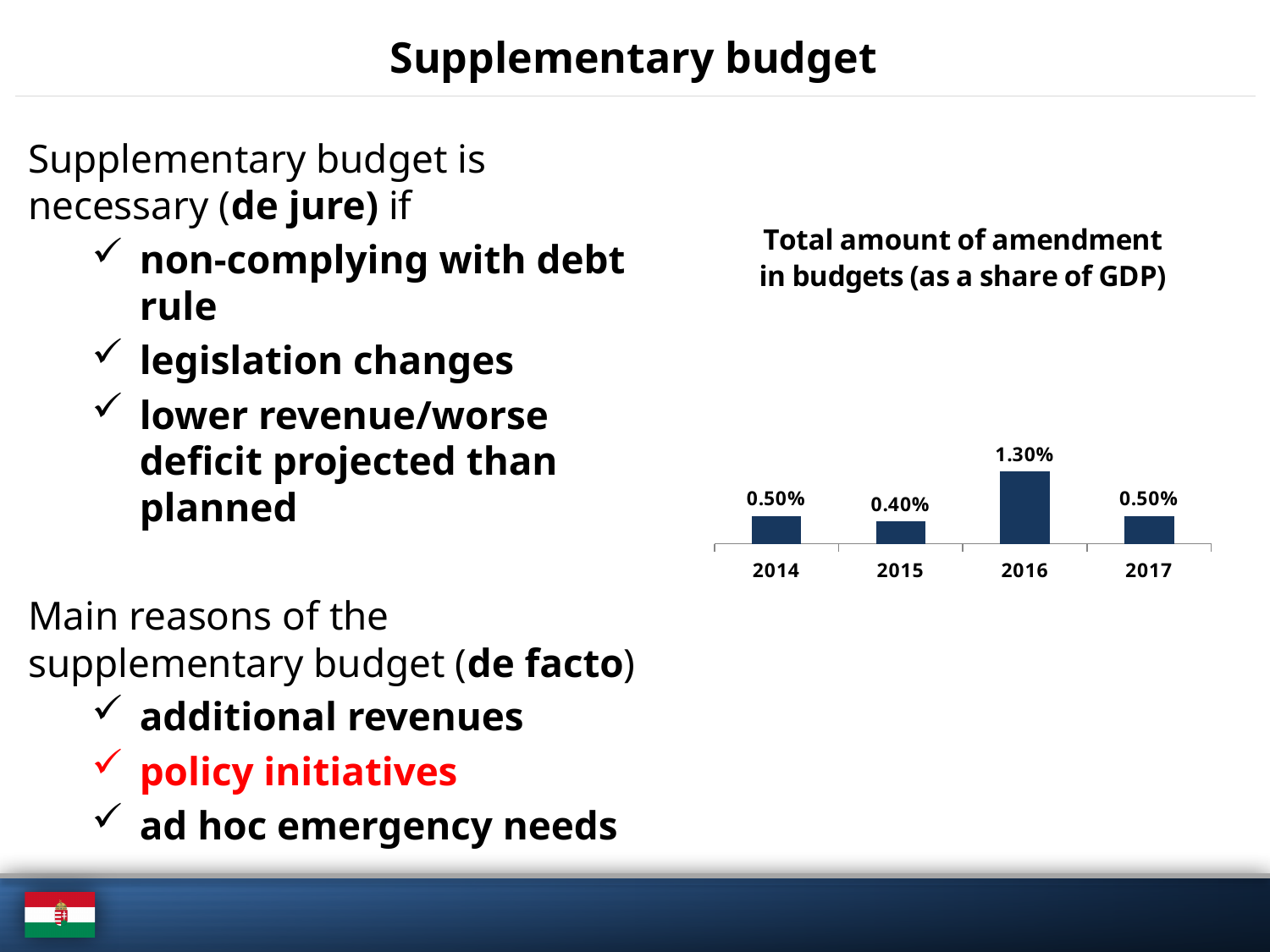
What is the difference between the values for 2014 and 2015? 0.10% What is the title of the chart? Total amount of amendment in budgets (as a share of GDP) What is the value for 2014 in the chart? 0.50% How many years are shown in the chart? 4 What kind of chart is shown on the slide? Bar chart What is the value for 2015 in the chart? 0.40% Which year has the highest total amount of amendment in budgets? 2016 What is the difference between the values for 2016 and 2015? 0.90% Do the values for 2014 and 2017 differ? No, both are 0.50% Which year has the lowest total amount of amendment in budgets? 2015 What is the value for 2016 in the chart? 1.30% Which is larger, the value for 2016 or the value for 2017? 2016